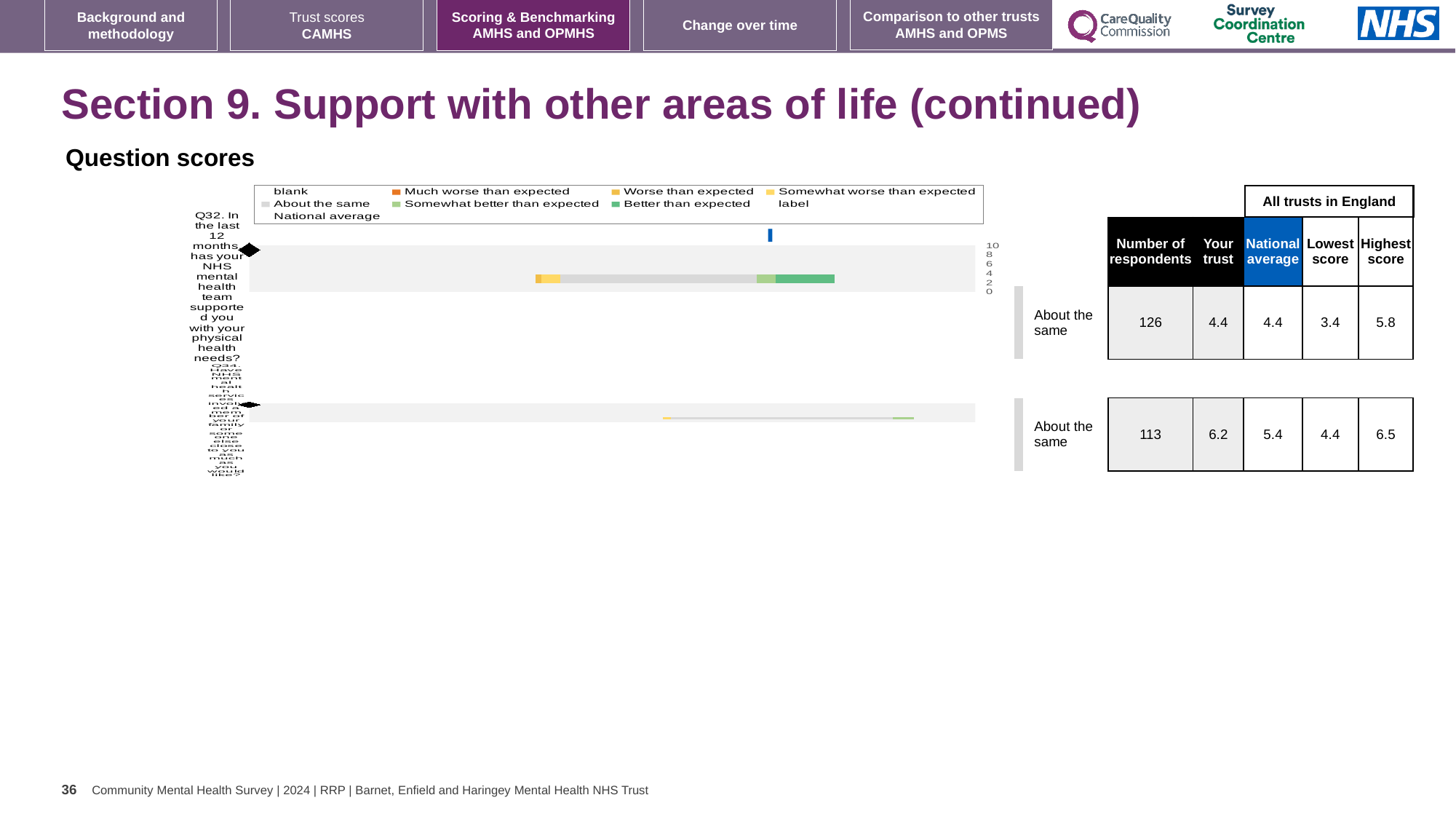
Which question had more respondents, Q32 or Q34? Q32 What is the difference between the highest and lowest scores for Q34? 2.1 What is the national average score for Q34? 5.4 What kind of chart is used to show the question scores on this slide? bar chart What benchmark category is shown next to the Q32 bar? About the same What is the 'Your trust' score for Q32 (support with physical health needs)? 4.4 How many respondents answered Q32? 126 What is the highest score across all trusts in England for Q34? 6.5 What is the difference between the highest and lowest scores for Q32? 2.4 What is the lowest score across all trusts in England for Q32? 3.4 How many questions are plotted in the question scores chart? 2 For Q34, which is larger: the 'Your trust' score or the national average? Your trust